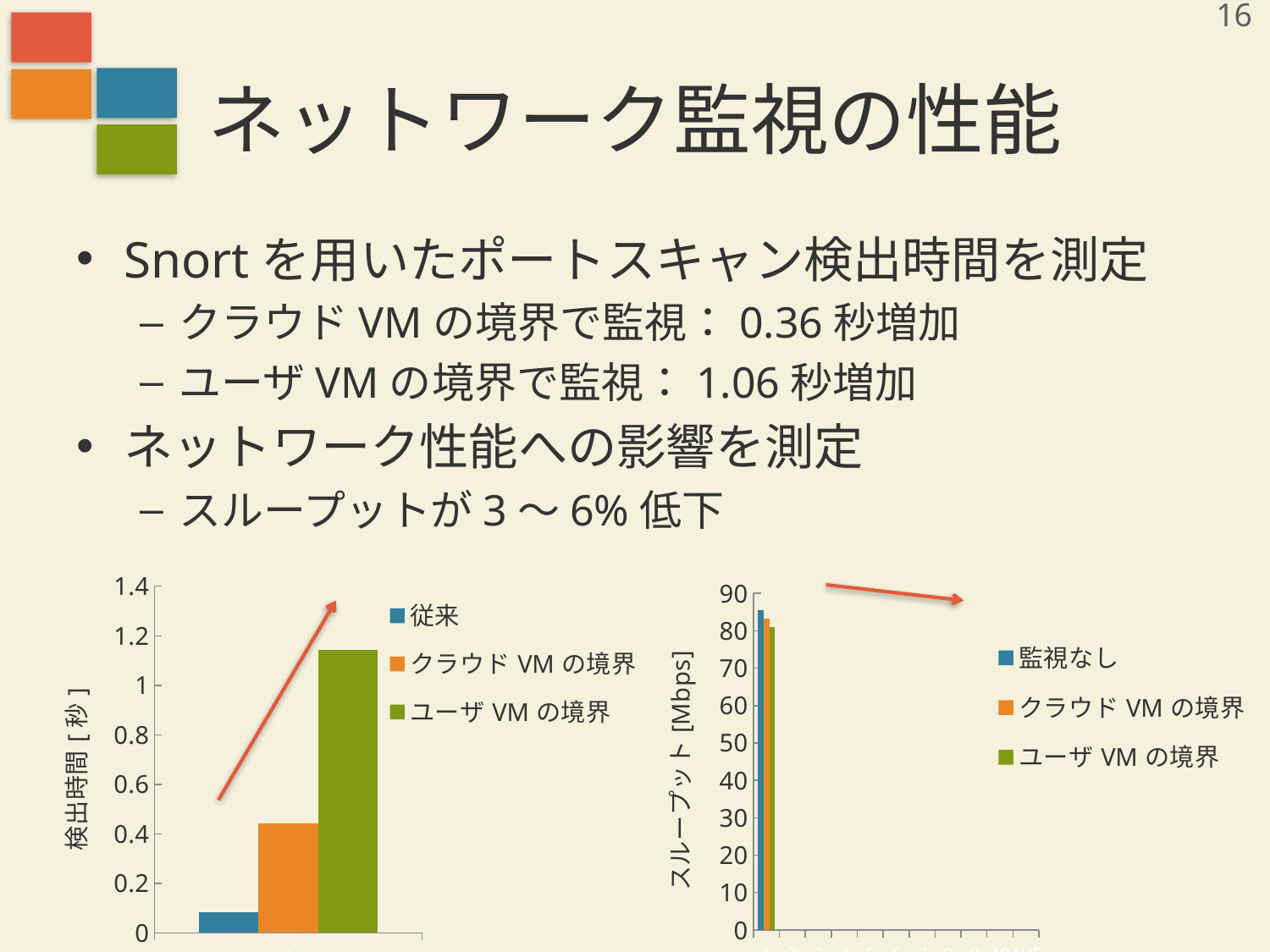
In the left chart (検出時間 [秒]), which is larger, the value for クラウド VM の境界 or the value for 従来? クラウド VM の境界 How many series does the legend of the right chart (スループット [Mbps]) list? 3 What kind of chart is the left chart (検出時間 [秒])? bar chart In the right chart (スループット [Mbps]), which is larger, the value for 監視なし or the value for ユーザ VM の境界? 監視なし In the left chart (検出時間 [秒]), which series has the highest detection time? ユーザ VM の境界 How many series does the legend of the left chart (検出時間 [秒]) list? 3 In the right chart (スループット [Mbps]), is the value for ユーザ VM の境界 greater or less than 70? greater In the left chart (検出時間 [秒]), is the value for クラウド VM の境界 greater or less than 0.6? less What is the y-axis title of the right chart? スループット [Mbps] In the left chart (検出時間 [秒]), is the value for ユーザ VM の境界 greater or less than 1? greater In the right chart (スループット [Mbps]), which series has the highest throughput? 監視なし In the left chart (検出時間 [秒]), which series has the lowest detection time? 従来